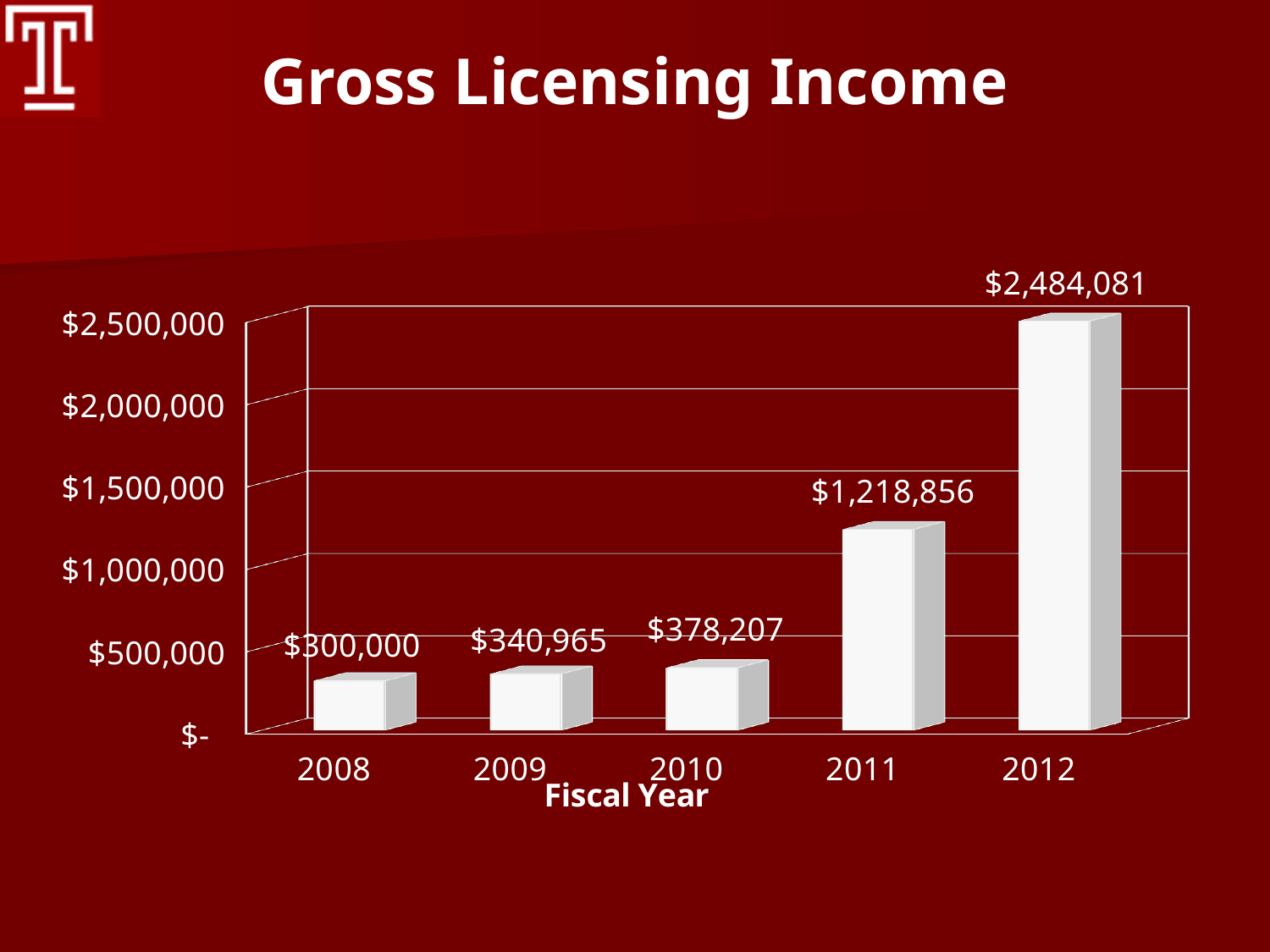
What is the gross licensing income for fiscal year 2008? $300,000 What is the difference in gross licensing income between fiscal years 2012 and 2011? $1,265,225 Does gross licensing income rise or fall from fiscal year 2008 to 2012? Rise Which fiscal year has the lowest gross licensing income? 2008 Which fiscal year has the larger gross licensing income, 2010 or 2011? 2011 What is the difference in gross licensing income between fiscal years 2010 and 2009? $37,242 Is the gross licensing income for fiscal year 2011 greater or less than $1,000,000? greater How many fiscal years are shown in the chart? 5 What is the gross licensing income for fiscal year 2009? $340,965 What kind of chart is used to show gross licensing income? Bar chart What is the gross licensing income for fiscal year 2011? $1,218,856 Which fiscal year has the highest gross licensing income? 2012